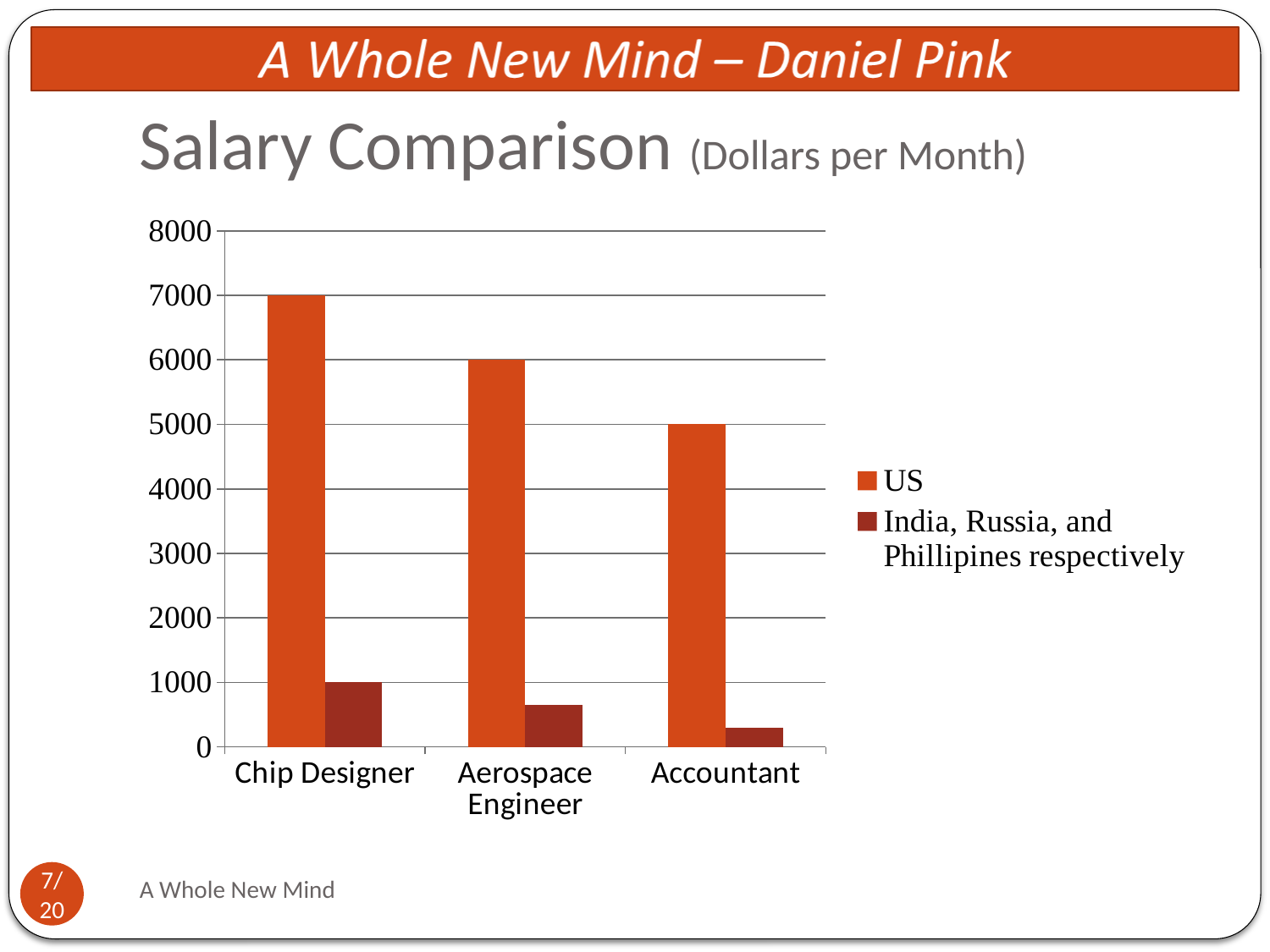
What is the difference between the US salary for a Chip Designer and the US salary for an Accountant? 2000 Which job category has the lowest US salary? Accountant Do the US salaries rise or fall from Chip Designer to Accountant along the x axis? fall What is the salary for a Chip Designer in the 'India, Russia, and Phillipines respectively' series? 1000 Which job category has the highest US salary? Chip Designer What type of chart is shown on the slide? bar chart What is the US salary for an Accountant? 5000 What is the US salary for an Aerospace Engineer? 6000 Is the 'India, Russia, and Phillipines respectively' value for Accountant greater or less than 1000? less How many series does the legend list? 2 What is the US salary for a Chip Designer? 7000 How many job categories are shown on the x axis? 3